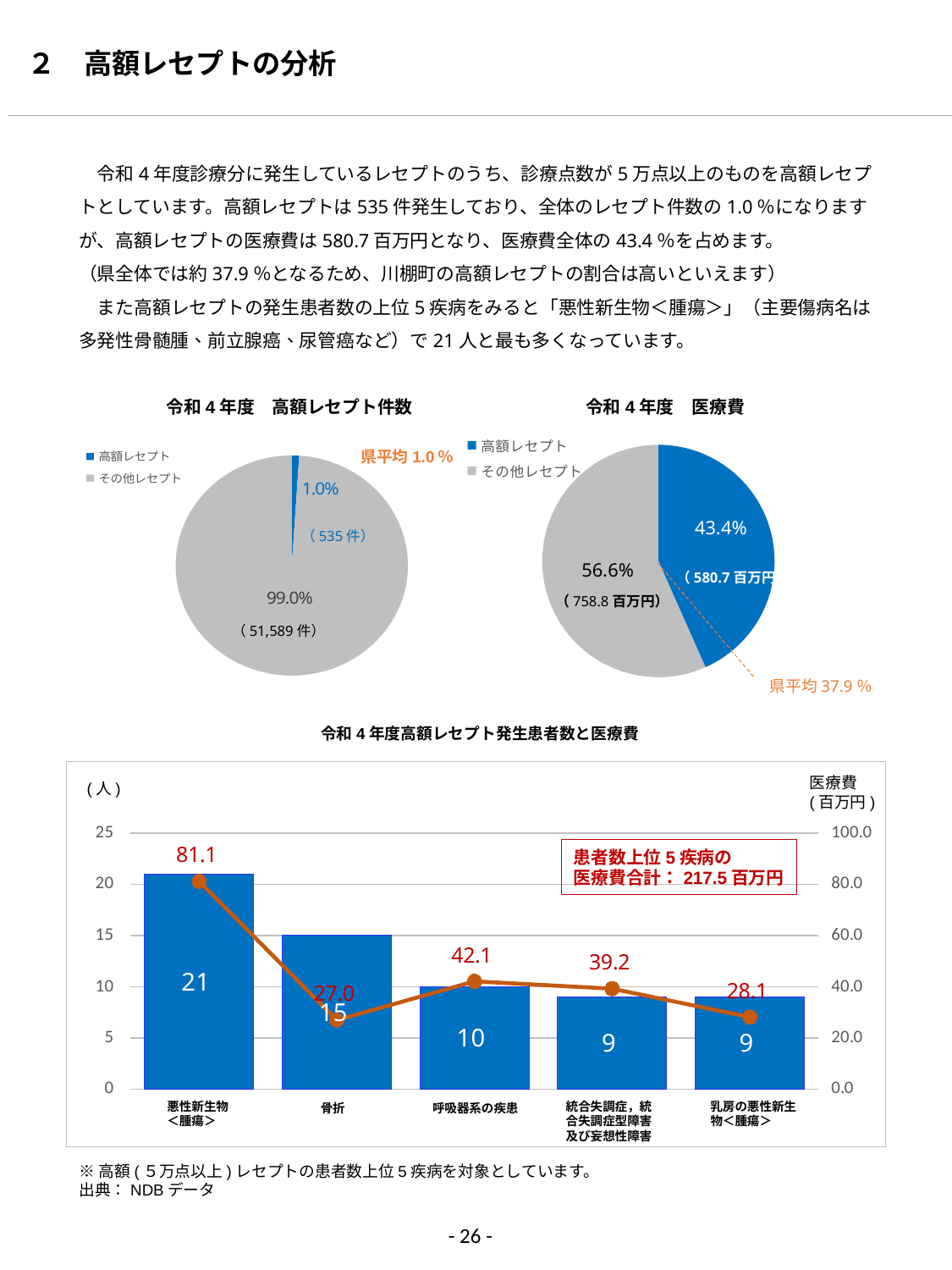
In the chart titled 令和4年度高額レセプト発生患者数と医療費, which disease has the lowest 医療費 value on the line? 骨折 In the pie chart titled 令和4年度 高額レセプト件数, how many 件 are shown for その他レセプト? 51,589 件 In the pie chart titled 令和4年度 高額レセプト件数, what share is 高額レセプト? 1.0% In the chart titled 令和4年度高額レセプト発生患者数と医療費, what is the difference in patient numbers between 悪性新生物＜腫瘍＞ and 呼吸器系の疾患? 11 In the chart titled 令和4年度高額レセプト発生患者数と医療費, which disease has the highest number of patients? 悪性新生物＜腫瘍＞ In the pie chart titled 令和4年度 医療費, what share is 高額レセプト? 43.4% In the chart titled 令和4年度高額レセプト発生患者数と医療費, what is the 医療費 value for 乳房の悪性新生物＜腫瘍＞? 28.1 In the pie chart titled 令和4年度 医療費, which slice is larger, 高額レセプト or その他レセプト? その他レセプト In the chart titled 令和4年度高額レセプト発生患者数と医療費, how many patients (人) are shown for 骨折? 15 In the chart titled 令和4年度高額レセプト発生患者数と医療費, how many disease categories are shown? 5 In the pie chart titled 令和4年度 医療費, what amount is shown for その他レセプト? 758.8 百万円 In the chart titled 令和4年度高額レセプト発生患者数と医療費, what is the 医療費 value for 呼吸器系の疾患? 42.1